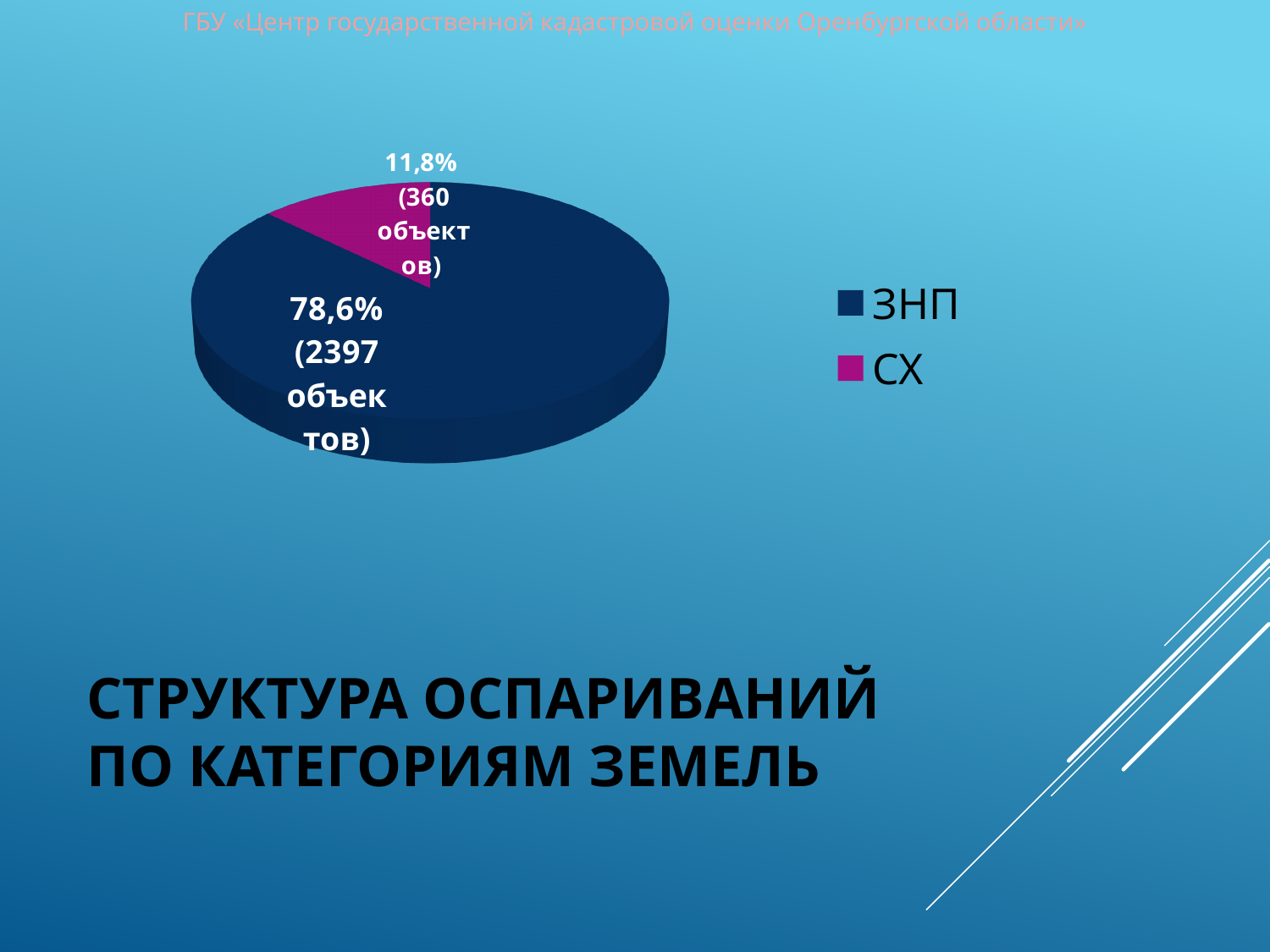
How many entries does the legend list? 2 What share of the pie does the ЗНП slice represent? 78,6% How many objects are in the СХ category? 360 объектов How many slices does the pie chart have? 2 Which category has more objects, ЗНП or СХ? ЗНП What share of the pie does the СХ slice represent? 11,8% Which category has the largest slice of the pie? ЗНП Which category has the smallest slice of the pie? СХ How many objects are in the ЗНП category? 2397 объектов What kind of chart is shown on the slide? Pie chart What is the difference in the number of objects between ЗНП and СХ? 2037 What colour is the СХ slice in the pie chart? Magenta